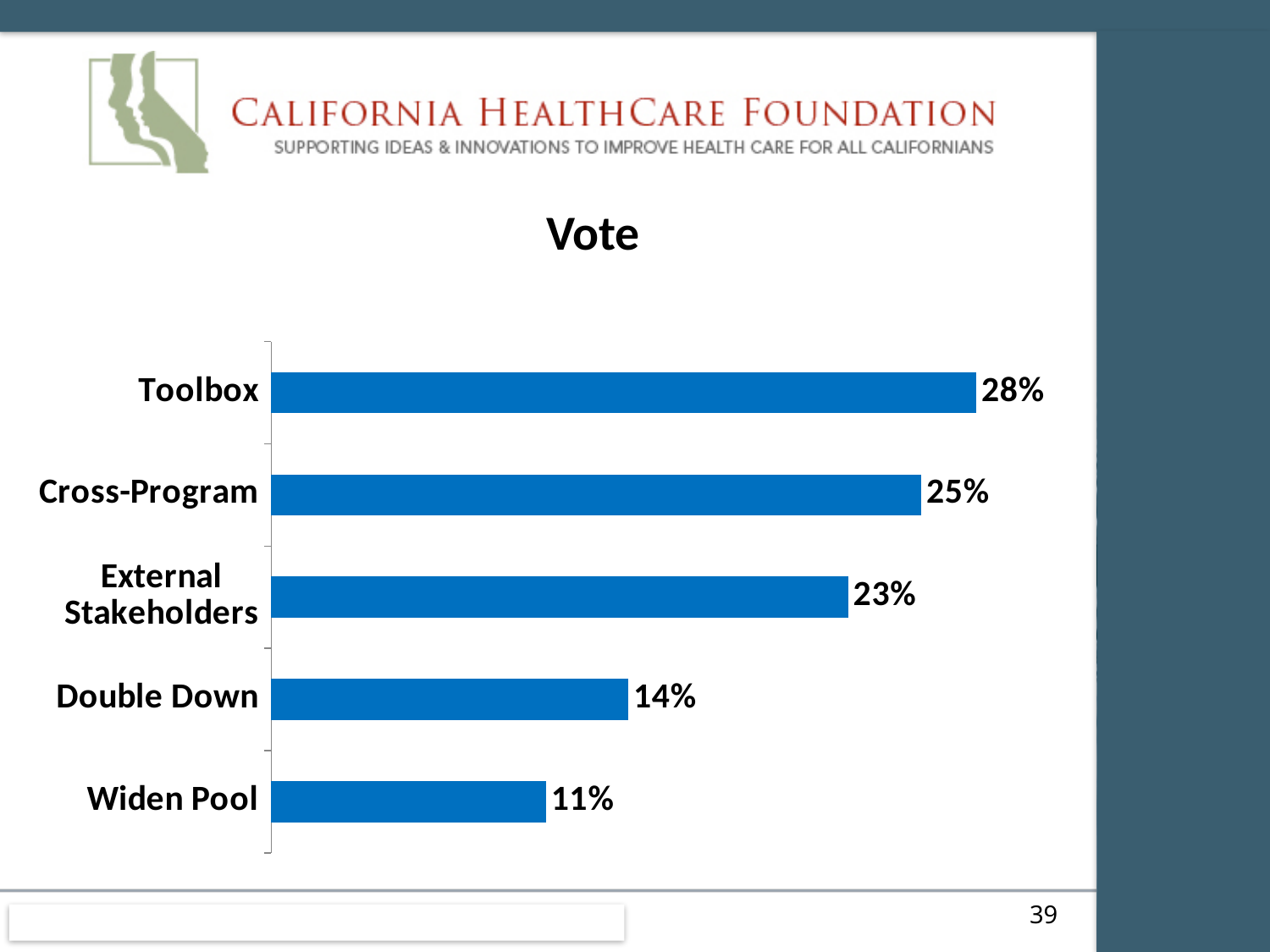
What is the value for Cross-Program? 25% What is the value for External Stakeholders? 23% Which is larger, the value for External Stakeholders or the value for Double Down? External Stakeholders What is the value for Double Down? 14% What is the difference between the values for Toolbox and Widen Pool? 17% What kind of chart is shown on the slide? Bar chart How many categories are shown in the chart? 5 Which category has the highest value? Toolbox Which category has the lowest value? Widen Pool What is the difference between the values for Cross-Program and Double Down? 11% What is the value for Widen Pool? 11% What is the value for Toolbox? 28%